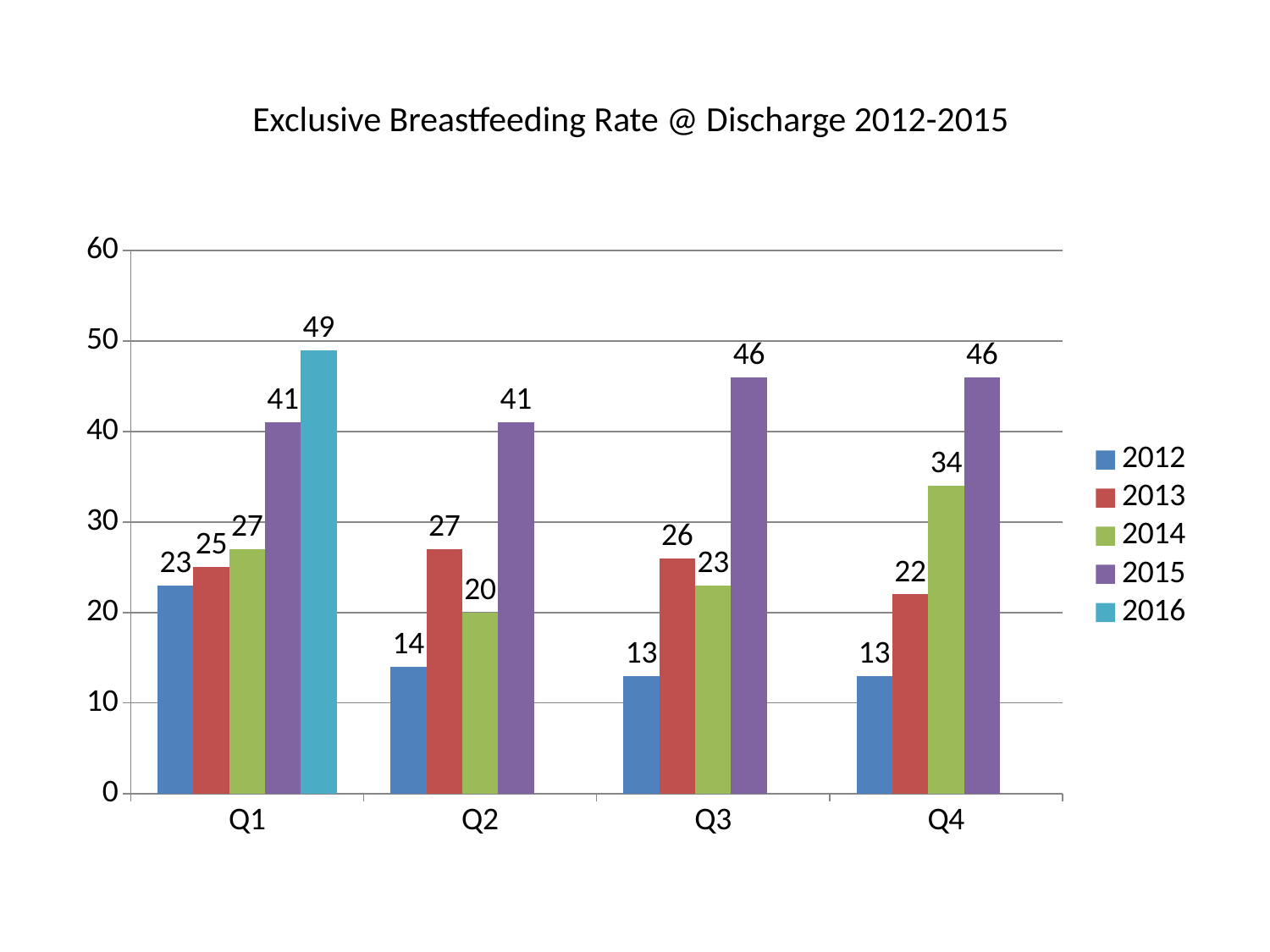
Which quarter has the highest value for 2013? Q2 What is the title of the chart? Exclusive Breastfeeding Rate @ Discharge 2012-2015 Which quarter has the lowest value for 2014? Q2 How many series does the legend list? 5 What is the value for 2015 in Q3? 46 What is the difference between the 2015 and 2012 values in Q1? 18 What kind of chart is shown on the slide? bar chart Which is larger in Q3: the value for 2013 or the value for 2014? 2013 What is the value for 2012 in Q2? 14 What is the value for 2014 in Q4? 34 How many quarters are shown on the x axis? 4 Is the value for 2016 in Q1 greater or less than 40? greater